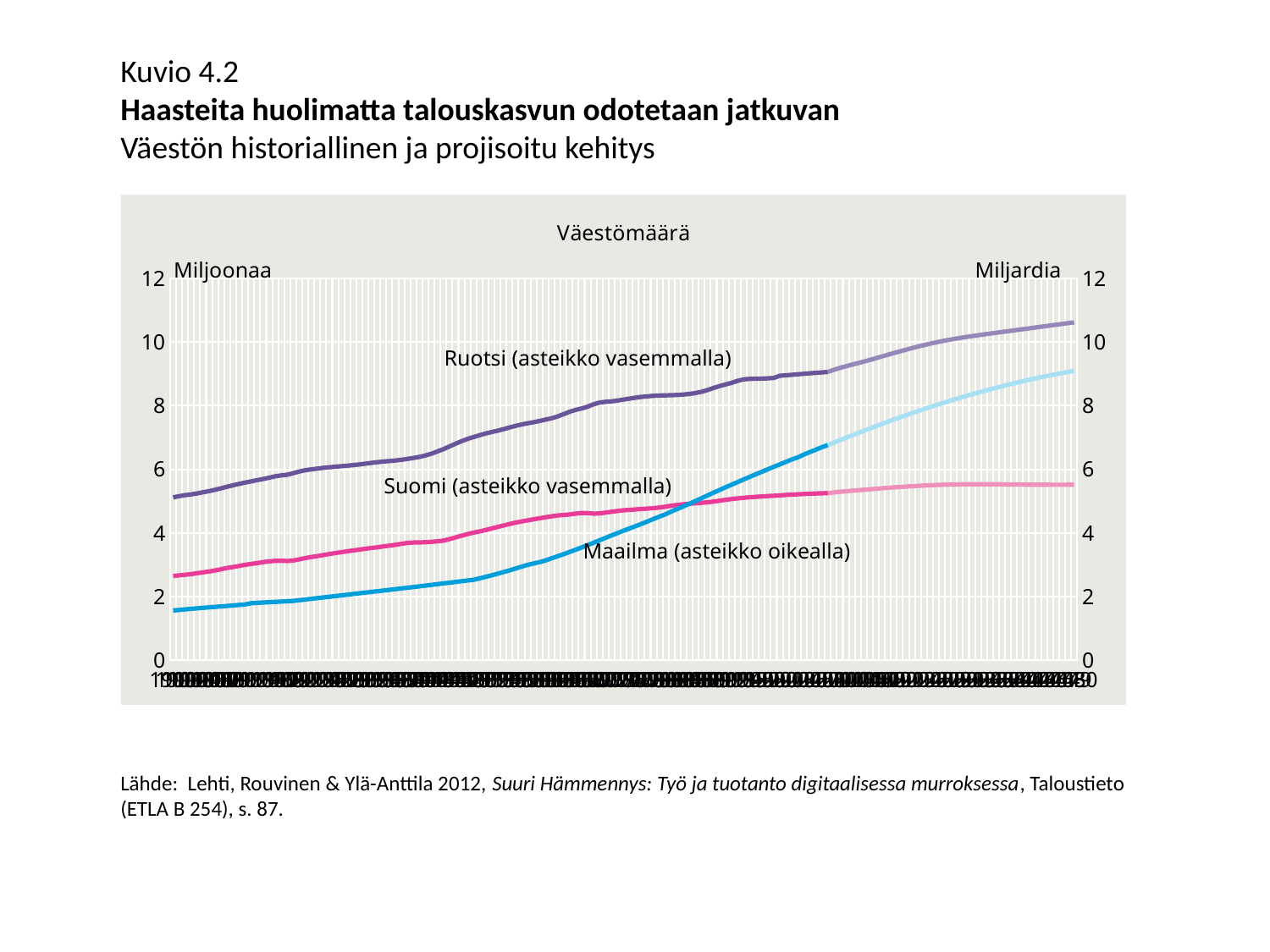
Is the value of the Ruotsi line at the left end of the chart greater or less than 4? greater How many lines (series) are plotted in the chart? 3 Does the Maailma line rise or fall from left to right? rise Which series is plotted against the right-hand axis? Maailma Is the value of the Suomi line at the right end of the chart greater or less than 6? less What is the title of the chart? Väestömäärä Is the value of the Maailma line at the right end of the chart greater or less than 8? greater What kind of chart is shown on the slide? line chart Does the Ruotsi line rise or fall from left to right? rise On the left-hand scale, which line is higher at the right end of the chart, Ruotsi or Suomi? Ruotsi